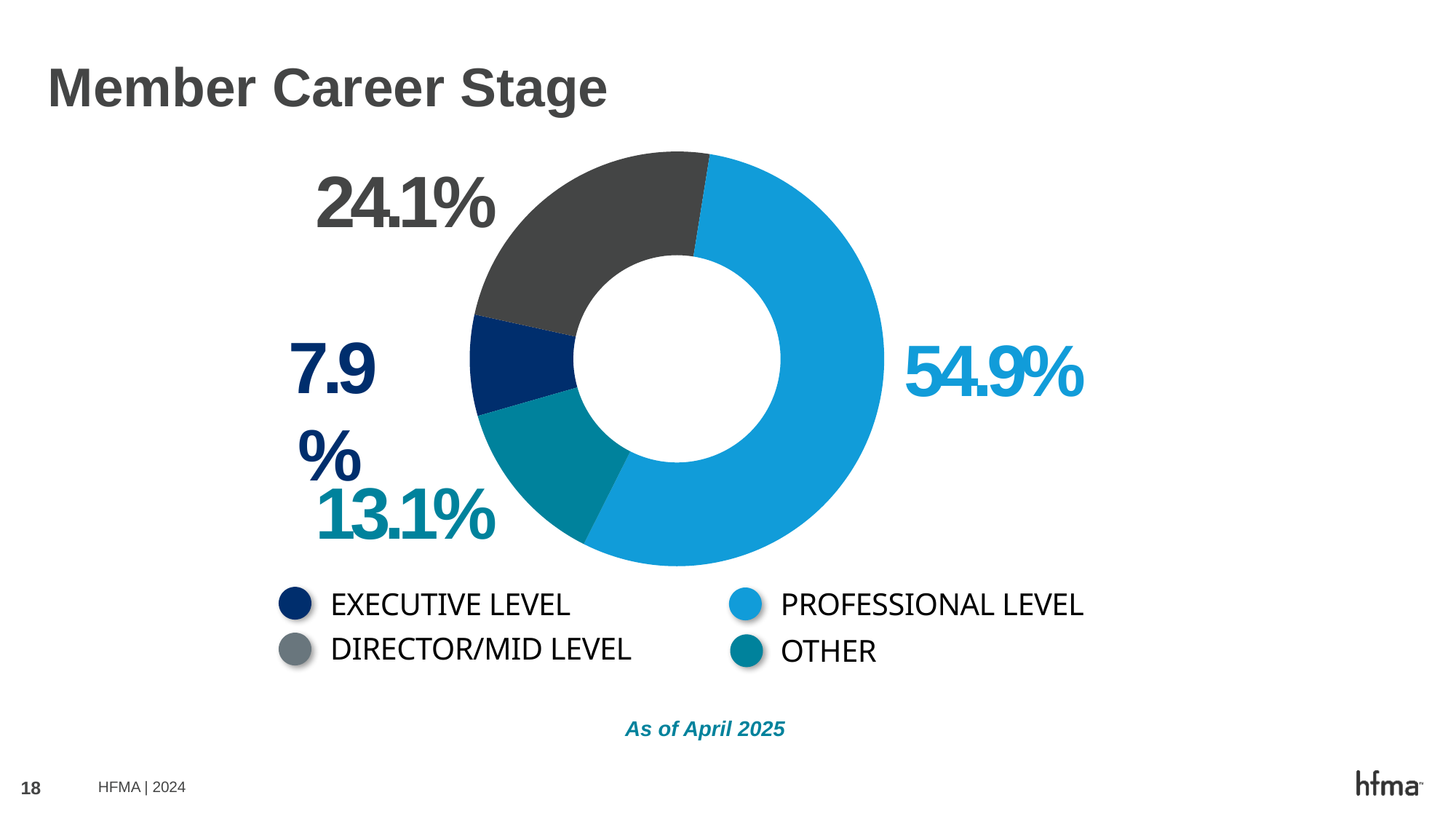
What is the title of the chart? Member Career Stage What percentage of members are at the Professional Level? 54.9% What type of chart is used to show member career stage? Pie chart (donut) What percentage of members fall into the Other category? 13.1% What percentage of members are at the Director/Mid Level? 24.1% How many career stage categories are shown in the chart? 4 Which is larger, the share for Other or the share for Executive Level? Other What percentage of members are at the Executive Level? 7.9% As of what date is the chart data reported? April 2025 Which career stage has the largest share of members? Professional Level What is the difference in percentage points between the Professional Level and Director/Mid Level shares? 30.8 Which career stage has the smallest share of members? Executive Level